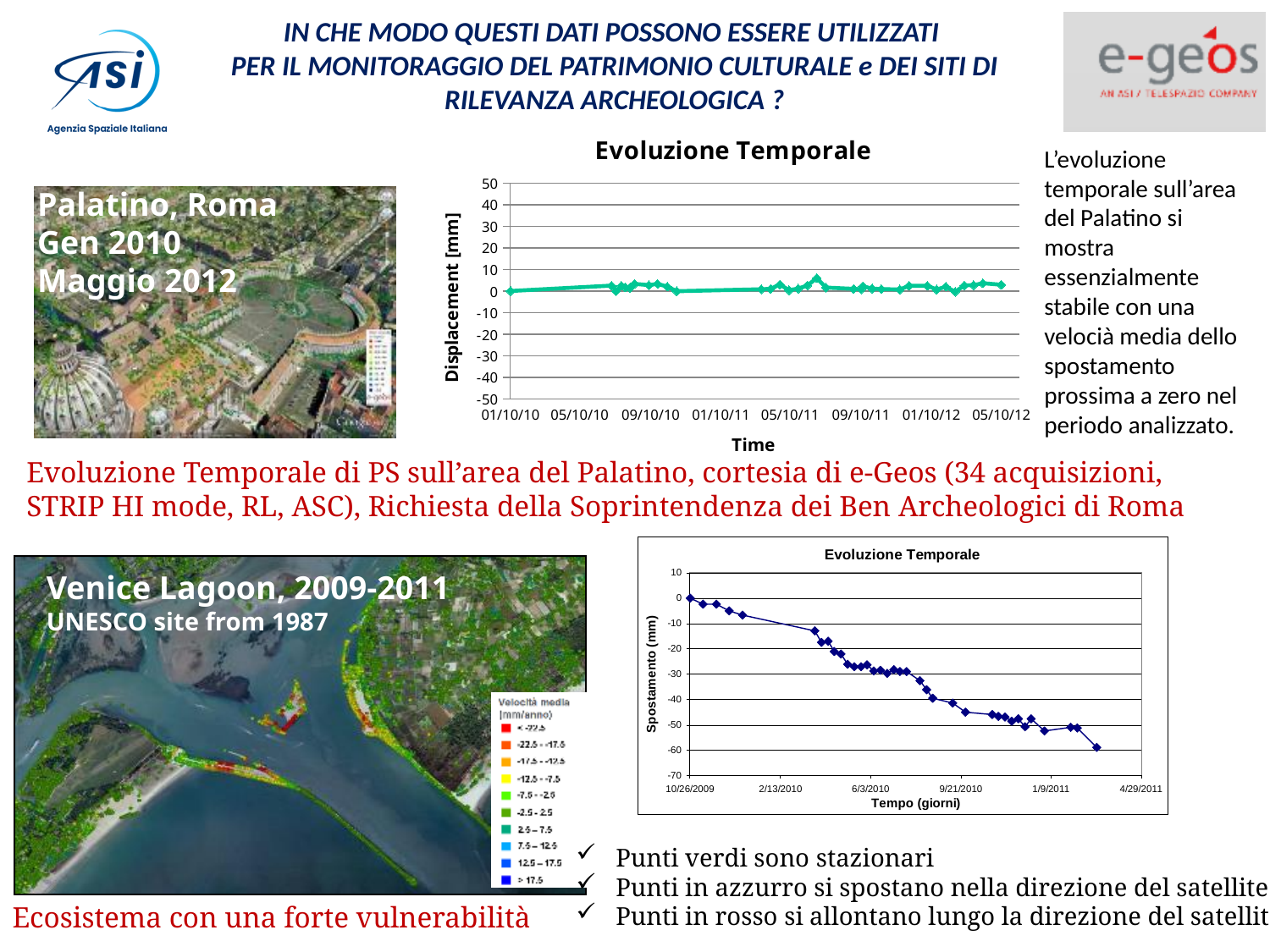
In the top 'Evoluzione Temporale' chart, what is the label of the y axis? Displacement [mm] In the top 'Evoluzione Temporale' chart, do the displacement values rise, fall, or stay roughly stable along the time axis? stay roughly stable In the bottom 'Evoluzione Temporale' chart, do the values rise or fall over time? fall In the bottom 'Evoluzione Temporale' chart, is the value plotted around 9/21/2010 greater or less than -30? less What kind of chart is the top 'Evoluzione Temporale' chart about the Palatino area? line chart In the top 'Evoluzione Temporale' chart, is the highest displacement value greater or less than 10? less In the bottom 'Evoluzione Temporale' chart, is the last plotted value greater or less than -50? less In the bottom 'Evoluzione Temporale' chart, what is the label of the x axis? Tempo (giorni) What kind of chart is the bottom 'Evoluzione Temporale' chart about the Venice Lagoon? line chart